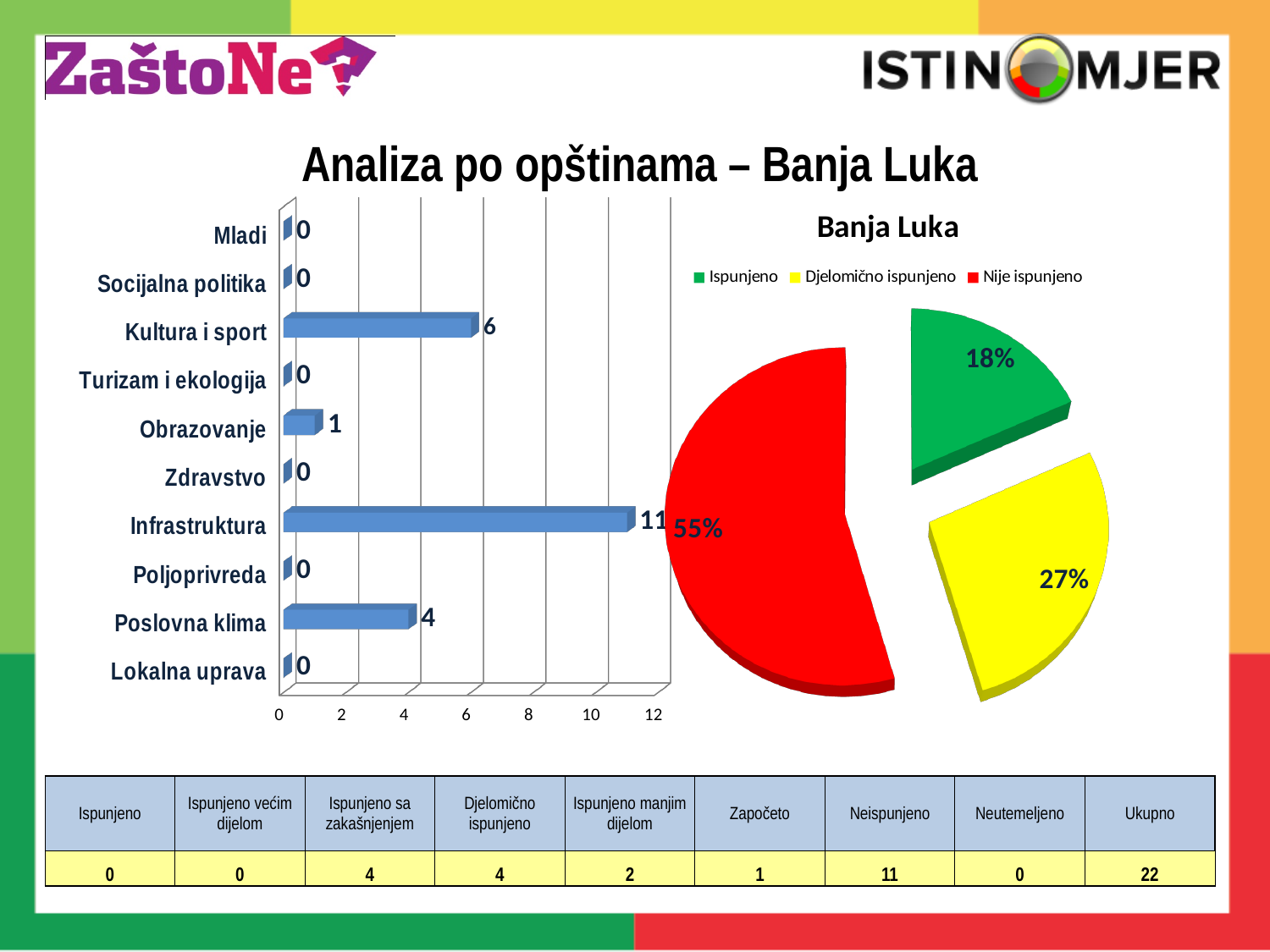
On the bar chart on the left, what is the value for Poslovna klima? 4 On the bar chart on the left, what is the difference between the values for Infrastruktura and Kultura i sport? 5 On the pie chart titled Banja Luka, what share does Djelomično ispunjeno have? 27% On the bar chart on the left, what is the value for Infrastruktura? 11 On the bar chart on the left, what is the value for Kultura i sport? 6 On the bar chart on the left, which category has the highest value? Infrastruktura On the pie chart titled Banja Luka, how many entries does the legend list? 3 On the pie chart titled Banja Luka, what share does Nije ispunjeno have? 55% What kind of chart is the chart on the left of the slide? Bar chart On the bar chart on the left, which is larger, the value for Poslovna klima or the value for Obrazovanje? Poslovna klima On the pie chart titled Banja Luka, which slice is the smallest? Ispunjeno On the bar chart on the left, how many categories are shown? 10